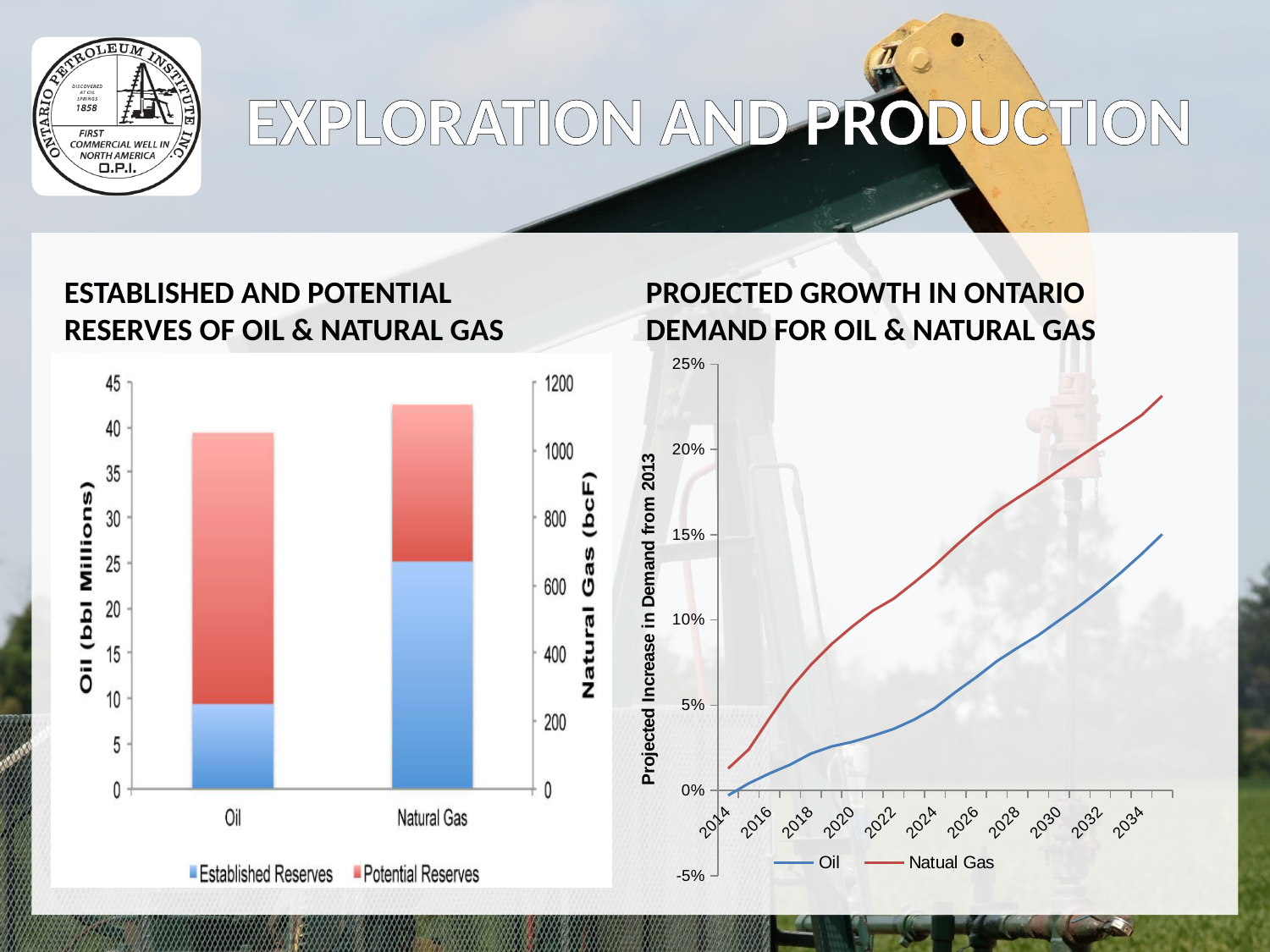
What kind of chart is the right chart, 'Projected Growth in Ontario Demand for Oil & Natural Gas'? Line chart In the right chart, does the Oil line rise or fall from 2014 to 2034? Rise In the left chart, is the total height of the Oil bar greater or less than 35 on the left axis? greater What is the title of the right-hand axis of the left chart? Natural Gas (bcF) In the left chart, is the Established Reserves value for Natural Gas greater or less than 600 on the right axis? greater In the right chart, which series is higher in 2030, Oil or Natural Gas? Natural Gas In the left chart, is the Established Reserves value for Oil greater or less than 10 on the left axis? less How many series does the legend of the right chart list? 2 How many series does the legend of the left chart list? 2 What kind of chart is the left chart, 'Established and Potential Reserves of Oil & Natural Gas'? Bar chart How many categories are shown on the x axis of the left chart? 2